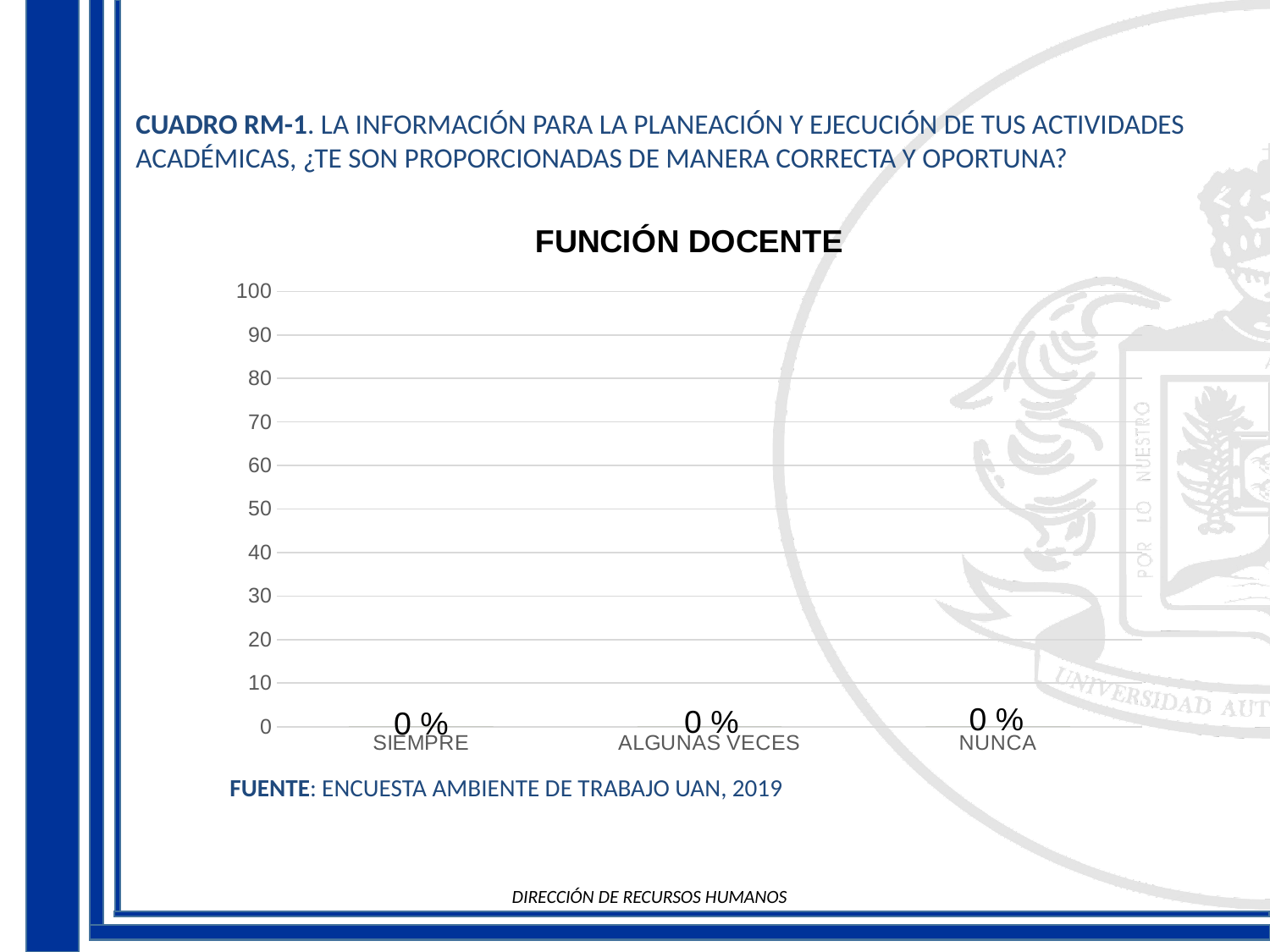
What is the value for NUNCA in the FUNCIÓN DOCENTE chart? 0 % Is the value for ALGUNAS VECES greater or less than 10? less What kind of chart is the FUNCIÓN DOCENTE chart? bar chart What is the highest value shown on the y axis of the chart? 100 What is the value for SIEMPRE in the FUNCIÓN DOCENTE chart? 0 % What is the title of the chart? FUNCIÓN DOCENTE What is the difference between the values for SIEMPRE and NUNCA? 0 % What is the value for ALGUNAS VECES in the FUNCIÓN DOCENTE chart? 0 % How many categories are shown on the x axis of the FUNCIÓN DOCENTE chart? 3 What is the sum of the values for SIEMPRE, ALGUNAS VECES and NUNCA? 0 %